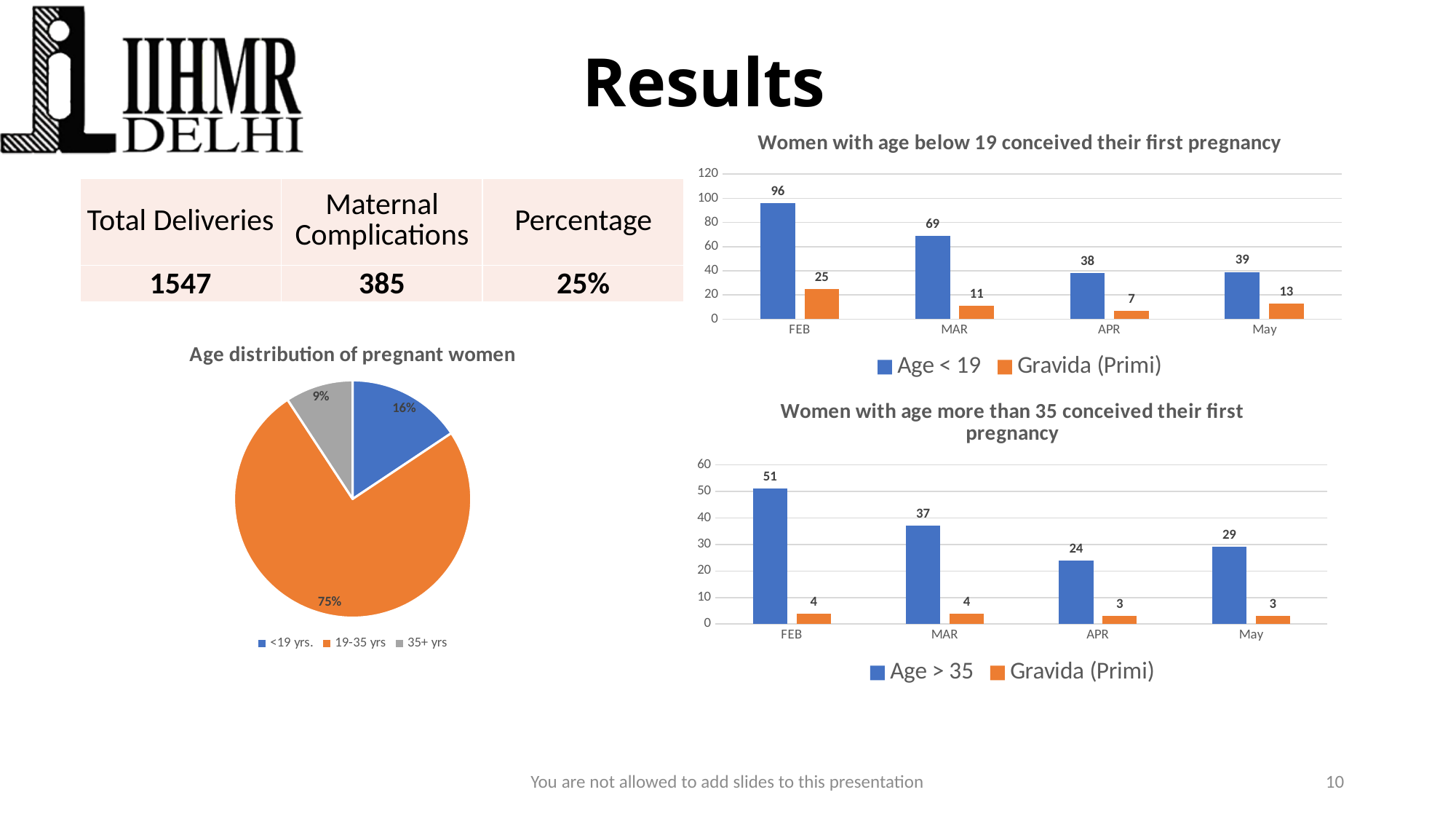
In the 'Women with age below 19 conceived their first pregnancy' chart, what is the difference between the Age < 19 value and the Gravida (Primi) value in MAR? 58 In the 'Women with age more than 35 conceived their first pregnancy' chart, which month has the lowest Age > 35 value? APR In the 'Women with age below 19 conceived their first pregnancy' chart, which month has the highest Age < 19 value? FEB In the 'Women with age below 19 conceived their first pregnancy' chart, what is the value for Age < 19 in FEB? 96 What kind of chart is the 'Women with age more than 35 conceived their first pregnancy' chart? bar chart In the 'Age distribution of pregnant women' pie chart, how many slices are there? 3 In the 'Women with age more than 35 conceived their first pregnancy' chart, is the Age > 35 value for MAR larger or smaller than the Age > 35 value for May? larger In the 'Women with age below 19 conceived their first pregnancy' chart, what is the value for Gravida (Primi) in APR? 7 In the 'Women with age more than 35 conceived their first pregnancy' chart, what is the value for Age > 35 in May? 29 In the 'Women with age below 19 conceived their first pregnancy' chart, how many series does the legend list? 2 In the 'Age distribution of pregnant women' pie chart, what share of the pie is the 19-35 yrs slice? 75% In the 'Age distribution of pregnant women' pie chart, which age group has the smallest slice? 35+ yrs